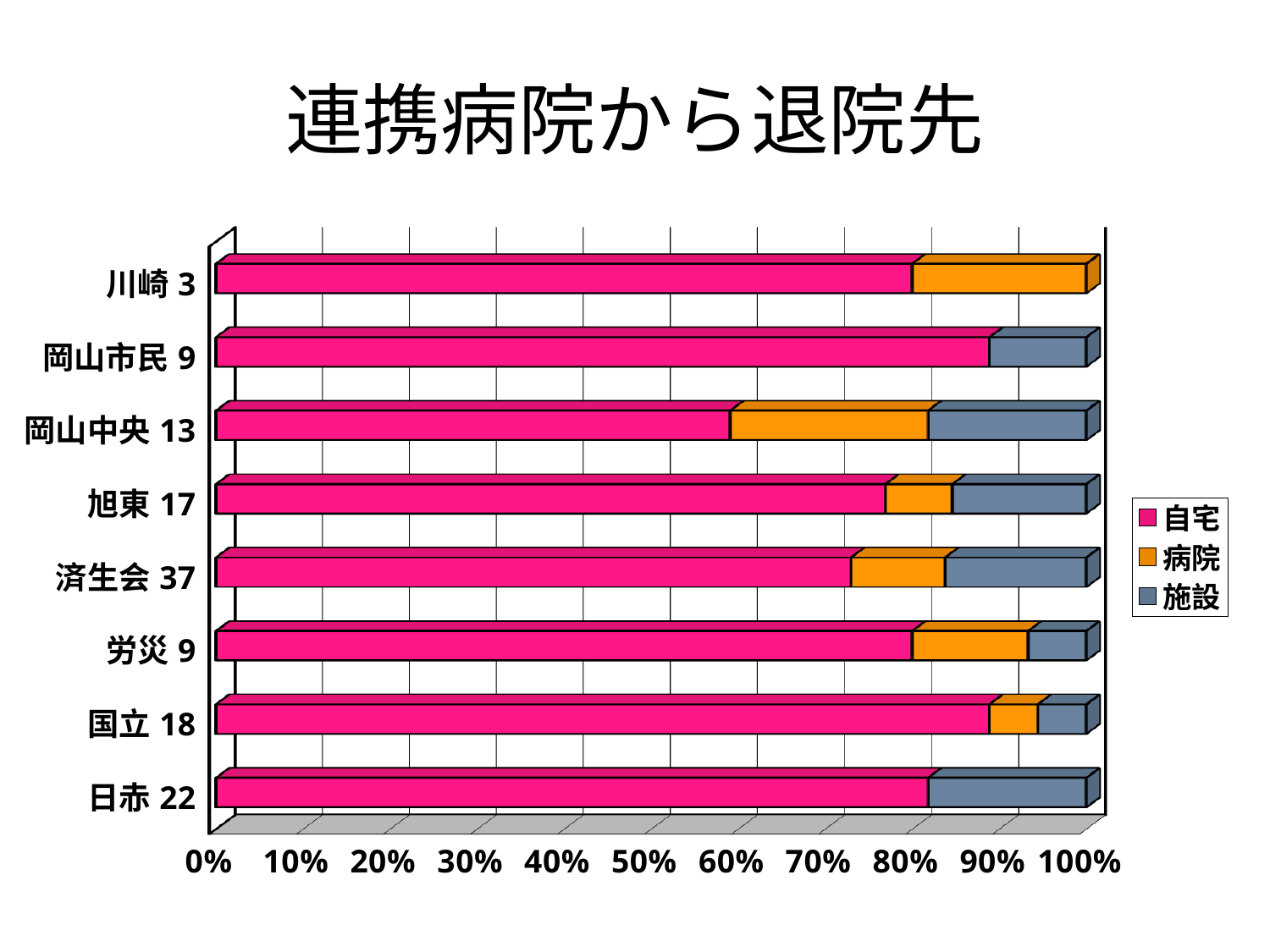
What is the title of the chart? 連携病院から退院先 What are the three legend entries of the chart? 自宅, 病院, 施設 How many hospitals (categories) are plotted on the chart? 8 Is the 自宅 share for 岡山中央 13 greater or less than 70%? less Which hospital has the lowest share of 自宅? 岡山中央 13 How many series does the legend list? 3 Is the 自宅 share for 岡山市民 9 greater or less than 80%? greater Is the 自宅 share for 旭東 17 greater or less than 90%? less Which has a larger 自宅 share, 川崎 3 or 岡山中央 13? 川崎 3 Which has a larger 病院 share, 岡山中央 13 or 旭東 17? 岡山中央 13 What kind of chart is shown on the slide? Stacked bar chart